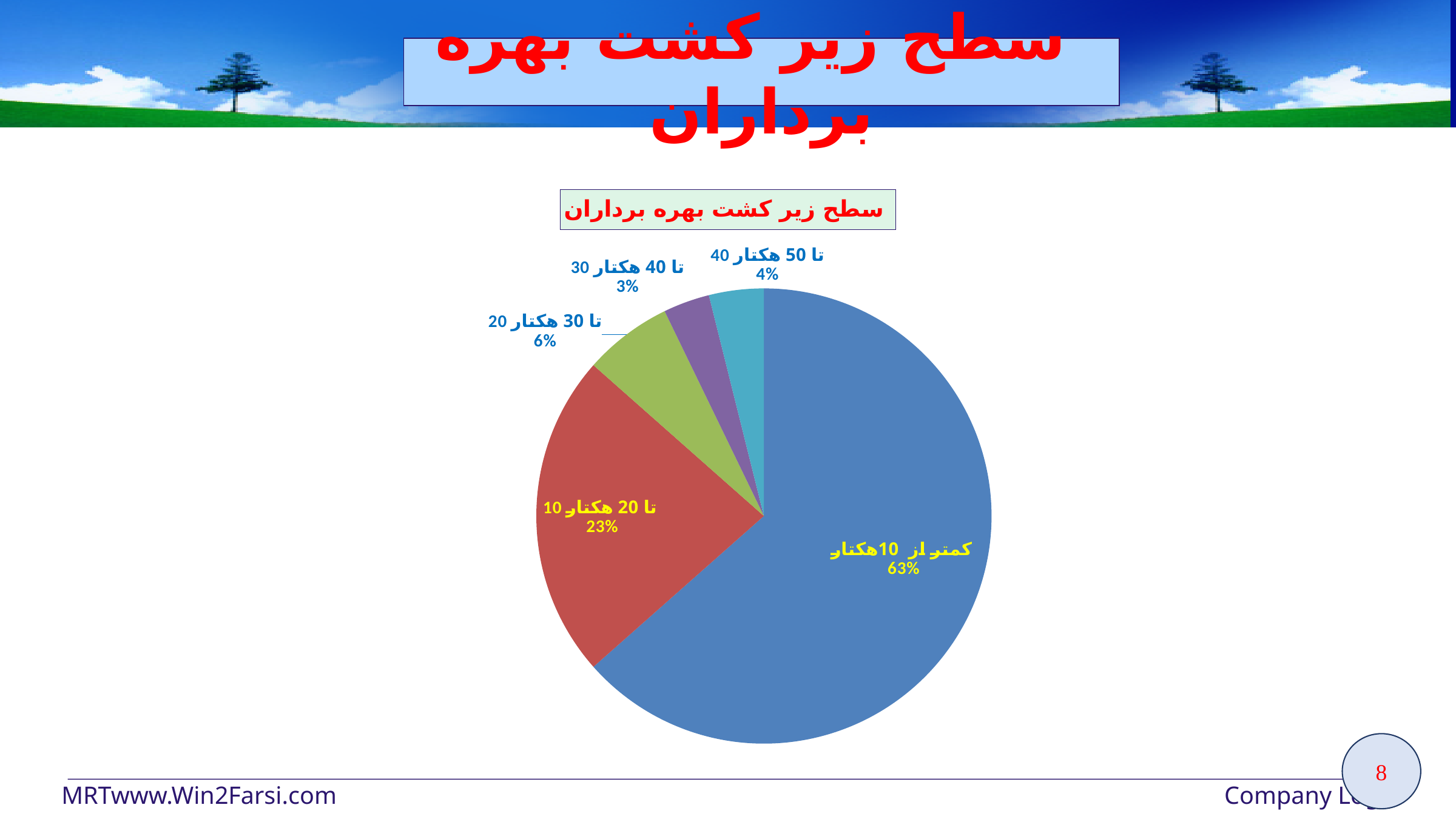
How many slices does the pie chart have? 5 What share of the pie is the slice labelled "10 تا 20 هکتار" (10 to 20 hectares)? 23% Which slice of the pie chart is the smallest? 30 تا 40 هکتار (3%) What share of the pie is the slice labelled "20 تا 30 هکتار" (20 to 30 hectares)? 6% What share of the pie is the slice labelled "30 تا 40 هکتار" (30 to 40 hectares)? 3% What kind of chart is shown on the slide? pie chart Which slice is larger: "20 تا 30 هکتار" or "40 تا 50 هکتار"? 20 تا 30 هکتار What is the title of the chart? سطح زیر کشت بهره برداران Which slice of the pie chart is the largest? کمتر از 10 هکتار (63%) What is the difference in percentage points between the "کمتر از 10 هکتار" slice and the "10 تا 20 هکتار" slice? 40 percentage points